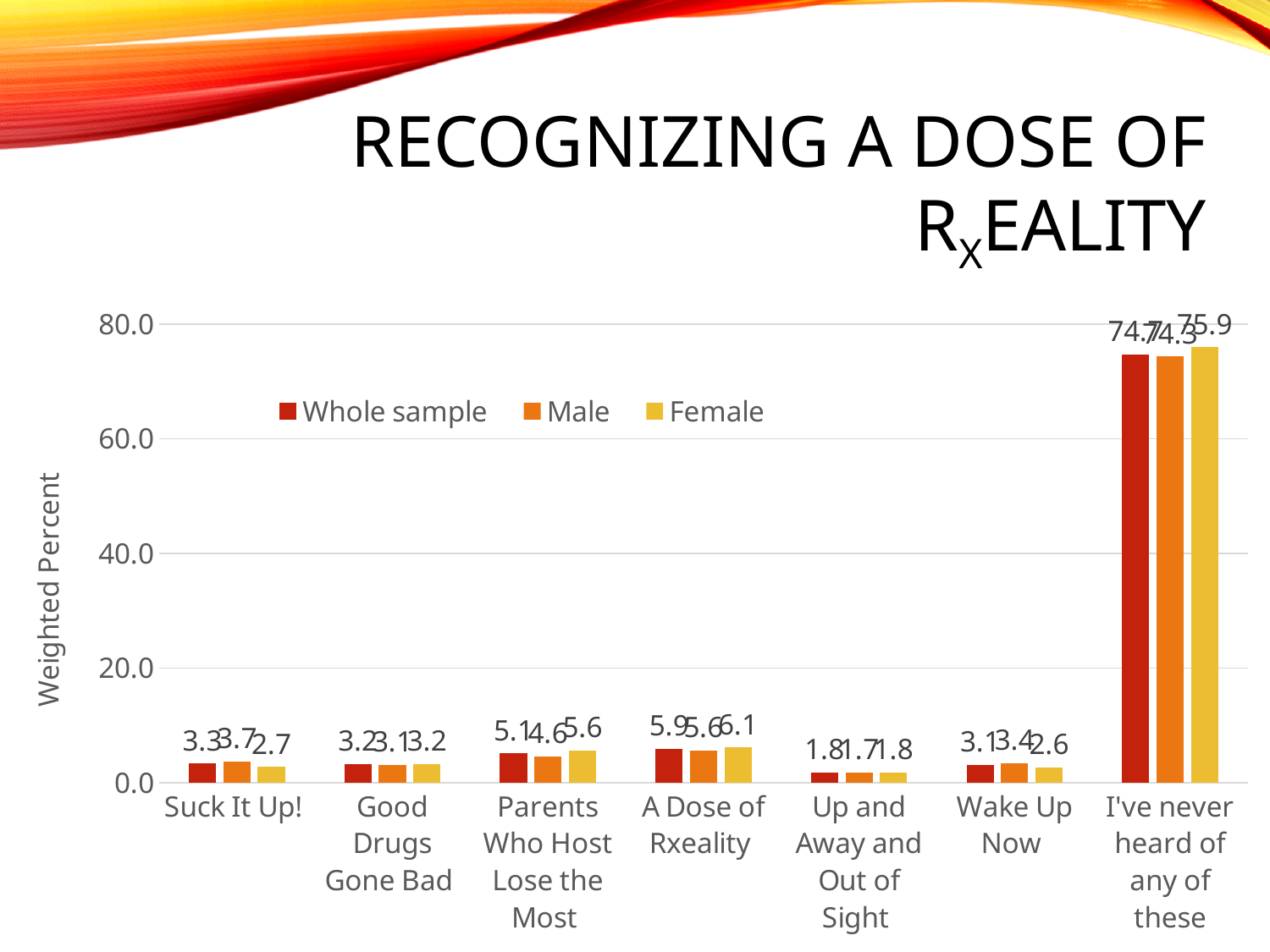
What is the Male value for "Wake Up Now"? 3.4 What kind of chart is shown on the slide? bar chart Which category has the lowest Whole sample value? Up and Away and Out of Sight Is the Whole sample value for "I've never heard of any of these" greater or less than 60.0? greater How many series does the legend list? 3 What is the Female value for "A Dose of Rxeality"? 6.1 What is the difference between the Female and Male values for "Parents Who Host Lose the Most"? 1.0 Which category has the highest Female value? I've never heard of any of these What is the Whole sample value for "Parents Who Host Lose the Most"? 5.1 How many categories are shown along the x axis? 7 For "Suck It Up!", which is larger, the Male value or the Female value? Male What is the title of the y axis? Weighted Percent